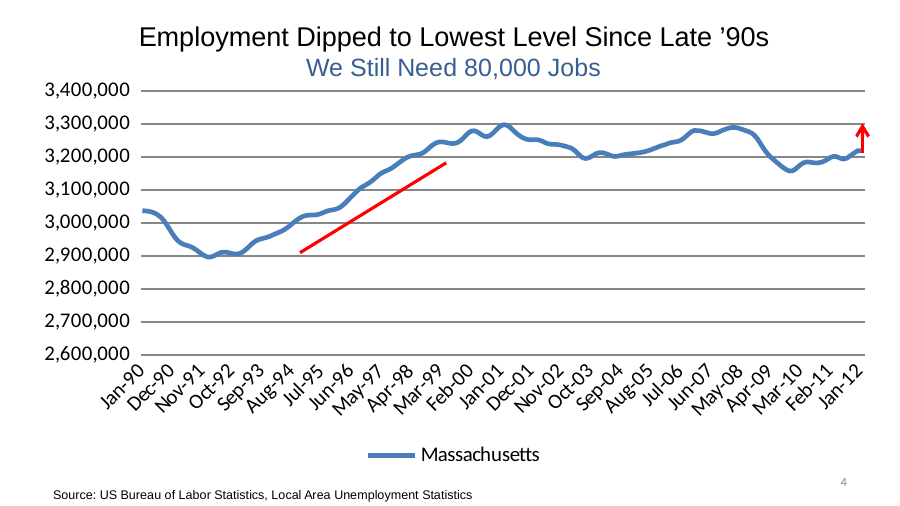
How many series does the legend list? 1 Is the value for Jan-01 greater or less than 3,200,000? greater Is the value for Sep-93 greater or less than 3,000,000? less Is the value for Jan-90 greater or less than 3,000,000? greater What is the name of the series shown in the legend? Massachusetts How many labels are shown on the x axis? 25 What kind of chart is shown on the slide? line chart What is the main title of the chart? Employment Dipped to Lowest Level Since Late '90s Do the values rise or fall between Jul-95 and Feb-00? rise Which is larger, the value for Jan-01 or the value for Mar-10? Jan-01